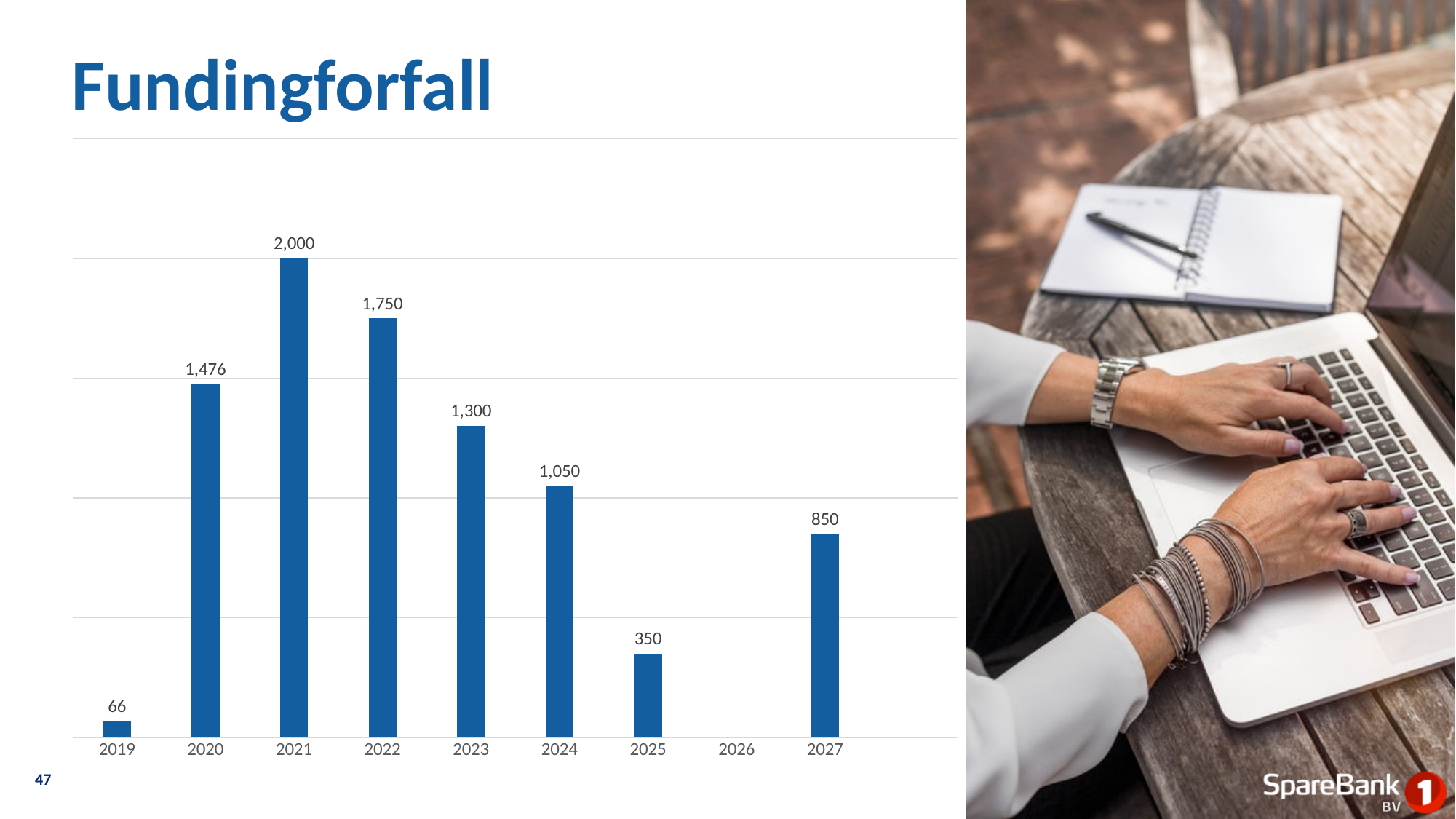
Which year has the highest value? 2021 How many years are shown on the x axis? 9 Which year with a visible bar has the lowest value? 2019 What is the difference between the values for 2021 and 2022? 250 Do the values rise or fall from 2021 to 2025? fall What is the value for 2021? 2,000 What is the value for 2027? 850 What is the title of the chart? Fundingforfall What kind of chart is shown? bar chart What is the difference between the values for 2020 and 2023? 176 Which is larger, the value for 2024 or the value for 2027? 2024 What is the value for 2019? 66